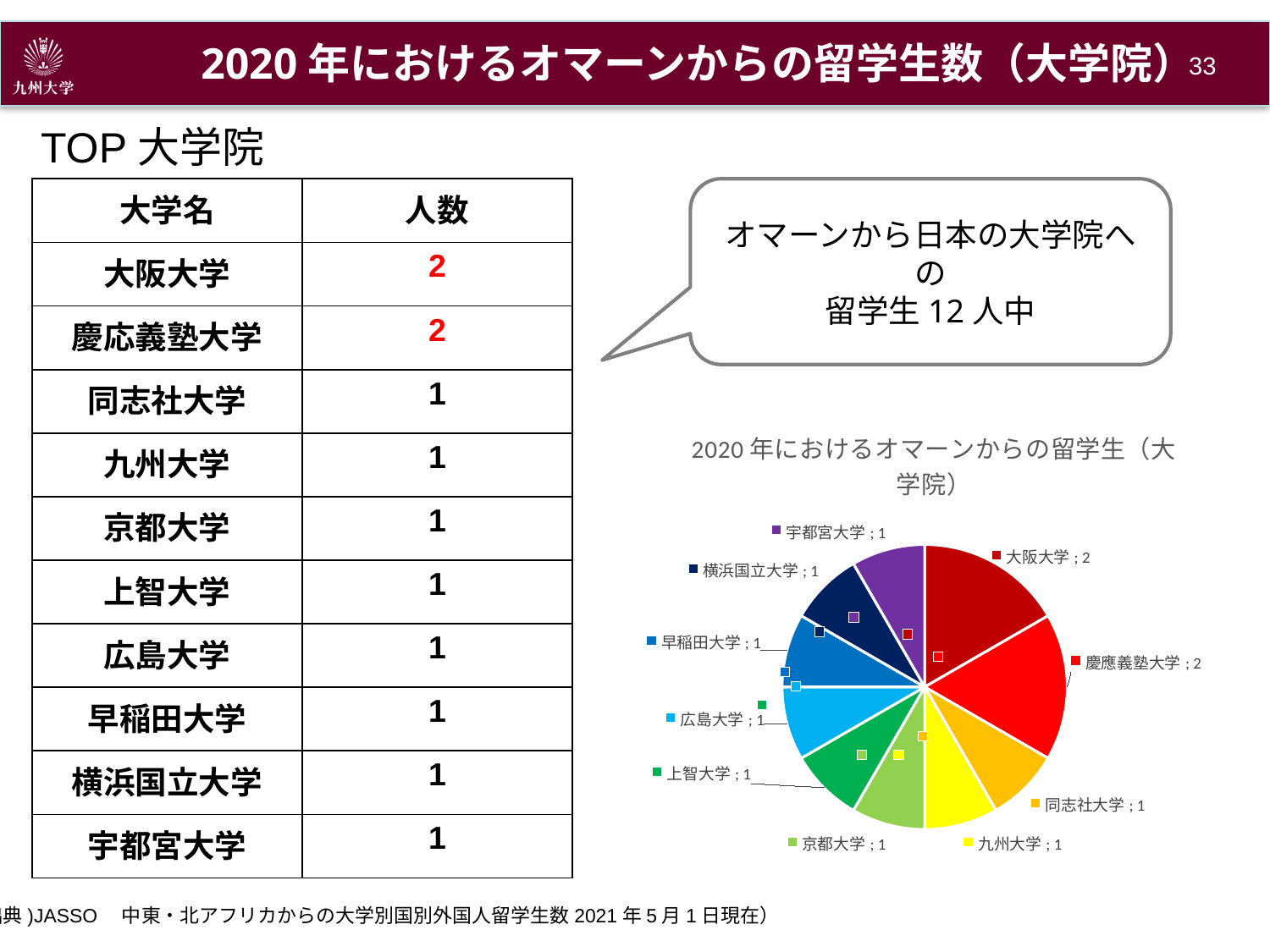
What is the value for 大阪大学 in the pie chart? 2 What colour is the slice for 九州大学 in the pie chart? yellow What kind of chart is shown on the slide? pie chart What is the total of all the values shown in the pie chart? 12 Which universities have the largest slices in the pie chart? 大阪大学 and 慶應義塾大学 What is the difference between the value for 慶應義塾大学 and the value for 同志社大学 in the pie chart? 1 What is the title of the pie chart? 2020年におけるオマーンからの留学生（大学院） How many slices does the pie chart have? 10 What is the value for 九州大学 in the pie chart? 1 What is the value for 慶應義塾大学 in the pie chart? 2 Which is larger in the pie chart, the value for 大阪大学 or the value for 早稲田大学? 大阪大学 What is the value for 宇都宮大学 in the pie chart? 1